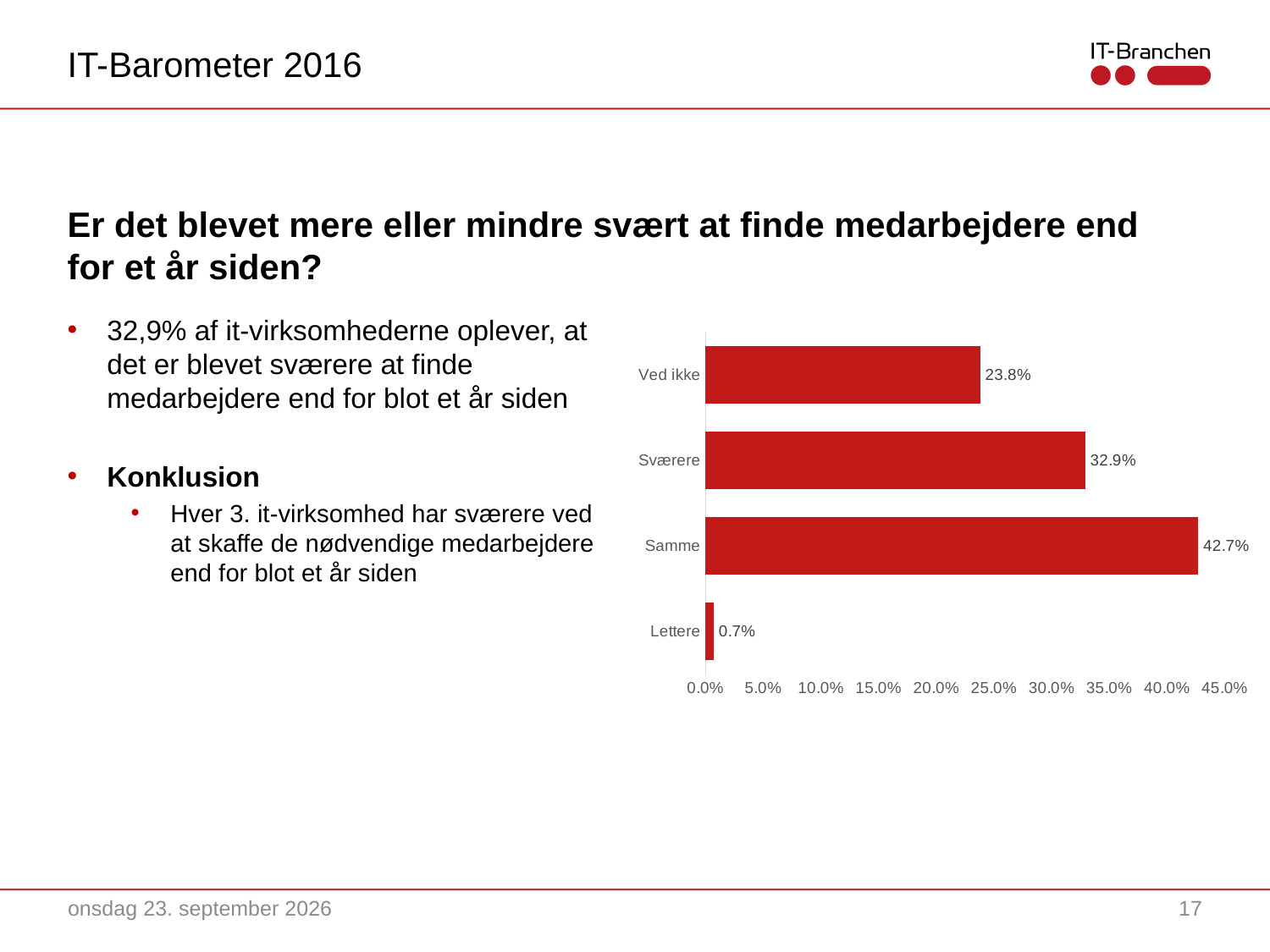
Which is larger, the value for Ved ikke or the value for Sværere? Sværere Is the value for Samme greater or less than 40.0%? greater What is the difference between the values for Sværere and Ved ikke? 9.1% How many categories are shown in the chart? 4 What is the difference between the values for Samme and Sværere? 9.8% What is the value for Lettere? 0.7% What is the value for Ved ikke? 23.8% Which category has the lowest value? Lettere Which category has the highest value? Samme What is the value for Samme? 42.7% What kind of chart is shown on the slide? bar chart What is the value for Sværere? 32.9%